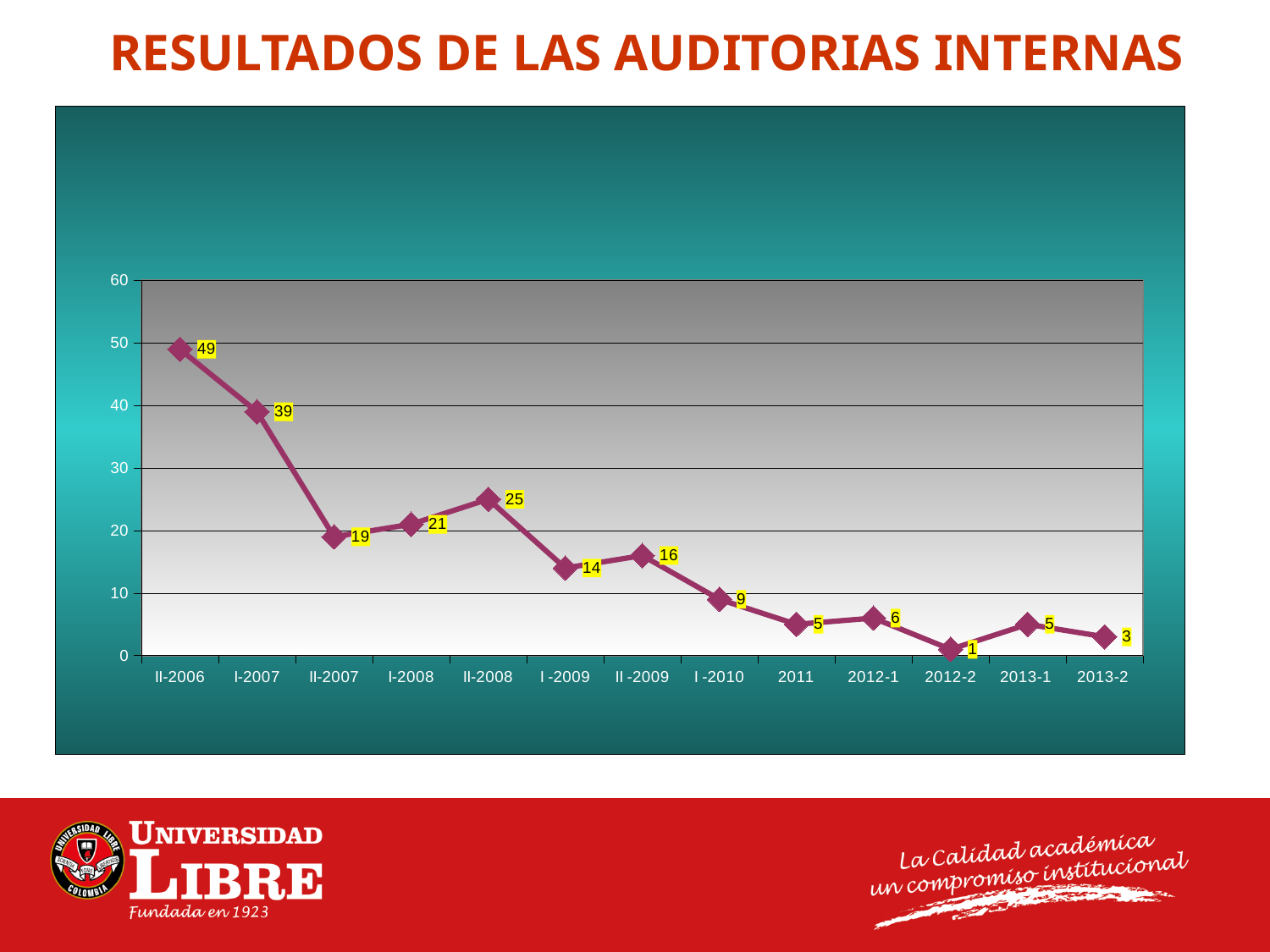
What is the value for II-2006? 49 Do the values generally rise or fall from II-2006 to 2013-2? fall Which period has the highest value? II-2006 Which is larger, the value for I-2008 or the value for I -2009? I-2008 How many periods are plotted on the x axis? 13 What kind of chart is shown on the slide? line chart What is the title of the slide? RESULTADOS DE LAS AUDITORIAS INTERNAS What is the value for II-2008? 25 What is the difference between the values for II-2006 and I-2007? 10 What is the value for 2012-2? 1 Which period has the lowest value? 2012-2 Is the value for I-2007 greater or less than 30? greater